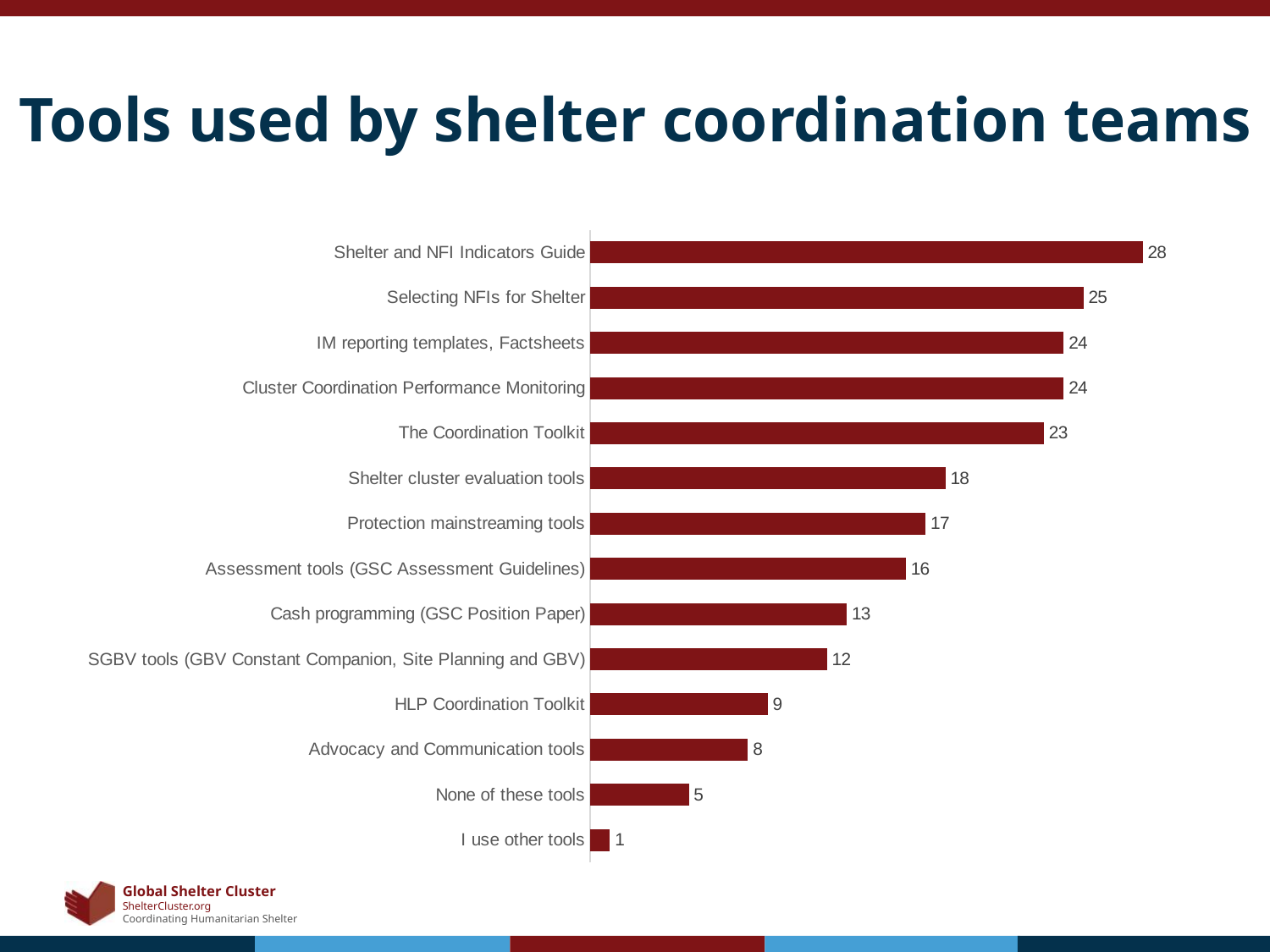
Which tool has the highest value? Shelter and NFI Indicators Guide What is the value for None of these tools? 5 What is the value for Cash programming (GSC Position Paper)? 13 Which category has the lowest value? I use other tools How many categories are shown in the chart? 14 What kind of chart is shown on the slide? Bar chart What is the value for Shelter and NFI Indicators Guide? 28 What is the difference between Selecting NFIs for Shelter and Shelter cluster evaluation tools? 7 What is the title of the slide? Tools used by shelter coordination teams What is the value for The Coordination Toolkit? 23 What is the difference between Advocacy and Communication tools and I use other tools? 7 Which is larger, Protection mainstreaming tools or HLP Coordination Toolkit? Protection mainstreaming tools